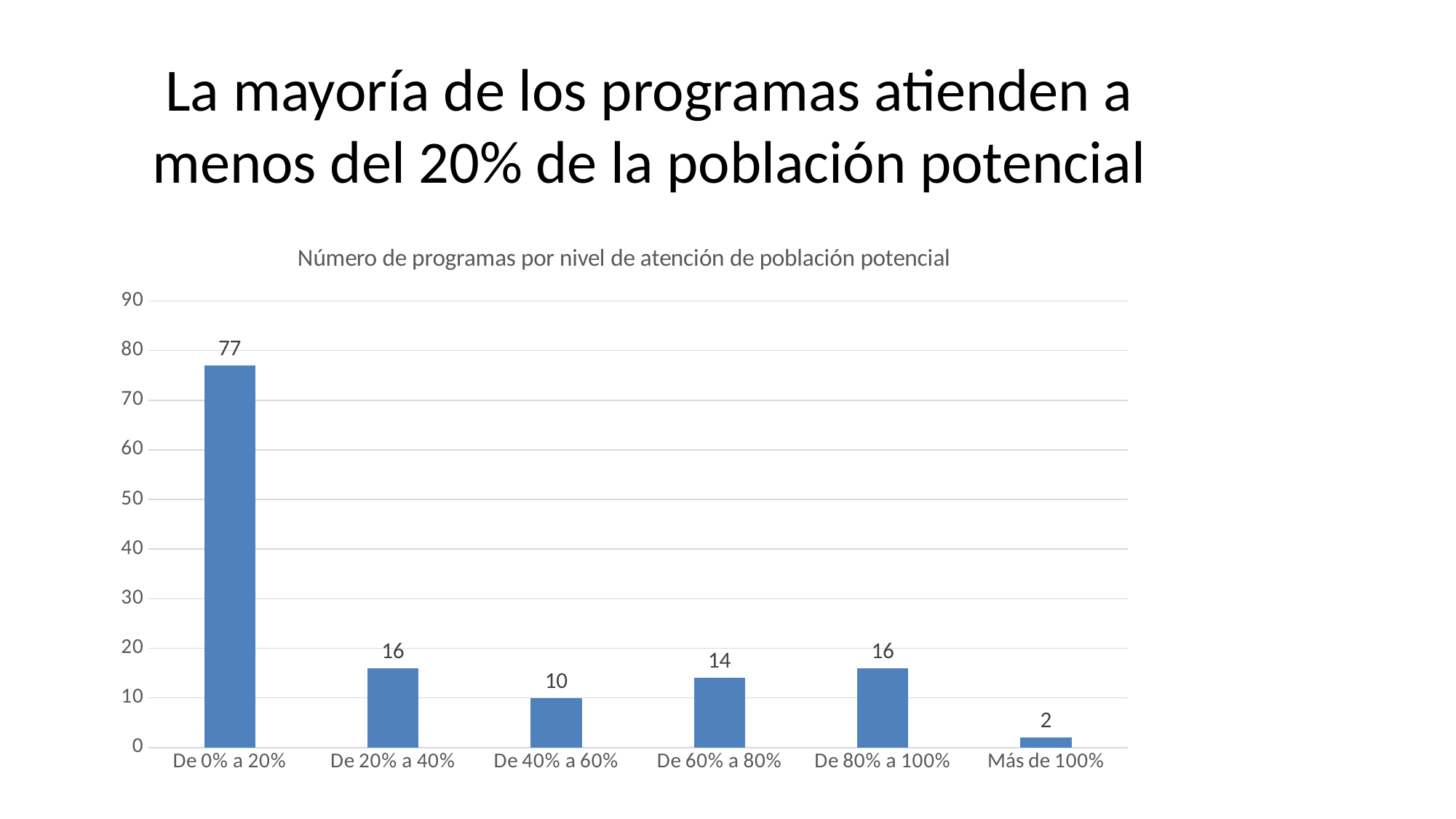
What is the difference between the values for 'De 0% a 20%' and 'De 20% a 40%'? 61 What is the value for the category 'De 40% a 60%'? 10 Which category has the lowest value? Más de 100% Which category has the highest value? De 0% a 20% Is the value for 'De 0% a 20%' greater or less than 70? greater Which is larger, the value for 'De 60% a 80%' or the value for 'De 40% a 60%'? De 60% a 80% How many categories are shown on the x axis? 6 What is the value for the category 'Más de 100%'? 2 What is the value for the category 'De 0% a 20%'? 77 What is the difference between the values for 'De 60% a 80%' and 'De 40% a 60%'? 4 What kind of chart is shown on the slide? bar chart What is the title of the chart? Número de programas por nivel de atención de población potencial